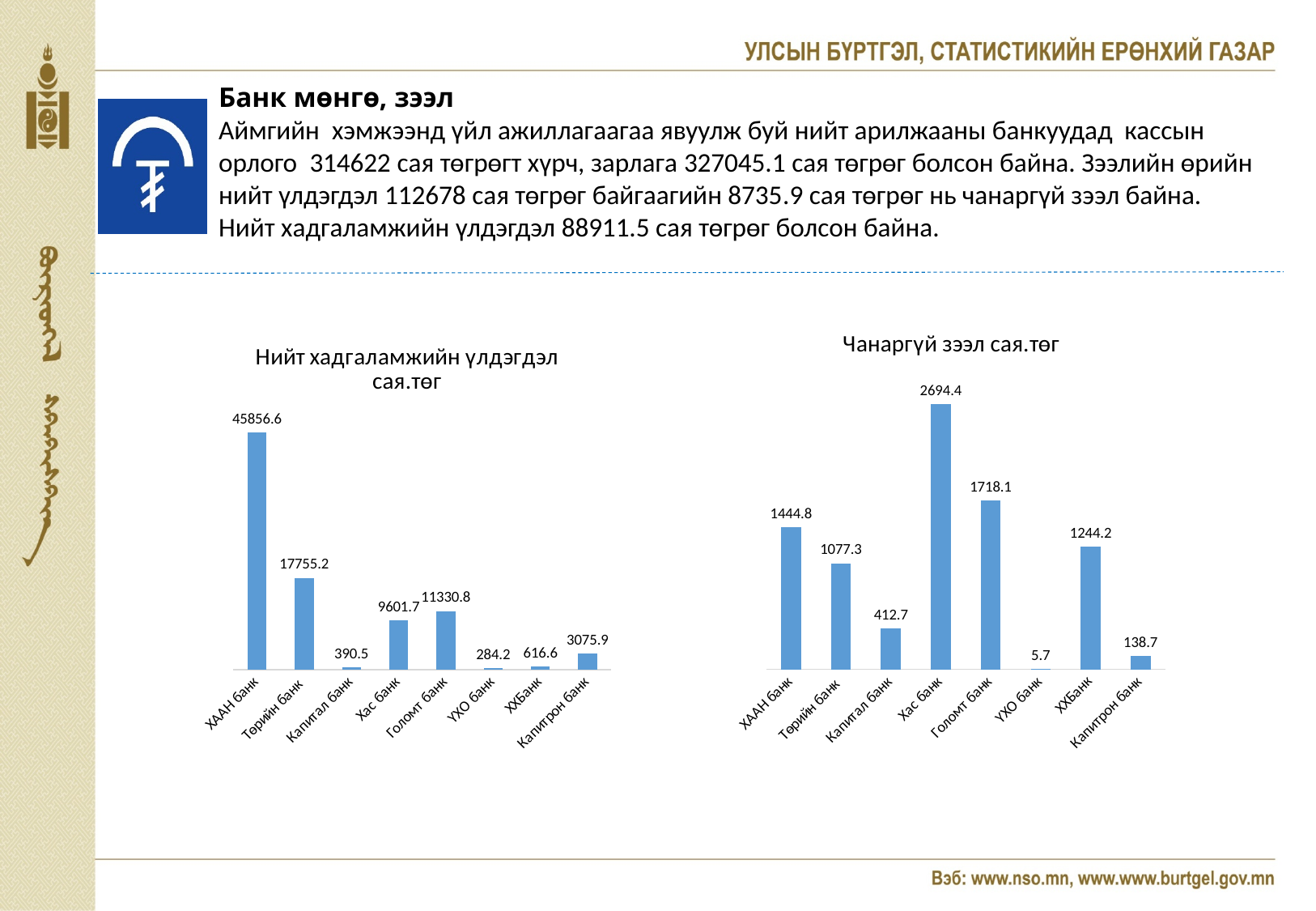
In the chart titled "Чанаргүй зээл сая.төг", what is the value for Хас банк? 2694.4 In the chart titled "Чанаргүй зээл сая.төг", what is the value for Капитрон банк? 138.7 What type of chart is the chart titled "Чанаргүй зээл сая.төг"? Bar chart In the chart titled "Чанаргүй зээл сая.төг", what is the difference between Хас банк and Голомт банк? 976.3 In the chart titled "Нийт хадгаламжийн үлдэгдэл сая.төг", what is the difference between ХААН банк and Төрийн банк? 28101.4 In the chart titled "Нийт хадгаламжийн үлдэгдэл сая.төг", what is the value for Голомт банк? 11330.8 In the chart titled "Чанаргүй зээл сая.төг", which bank has the lowest value? ҮХО банк In the chart titled "Чанаргүй зээл сая.төг", which is larger, ХААН банк or ХХБанк? ХААН банк In the chart titled "Нийт хадгаламжийн үлдэгдэл сая.төг", how many banks are shown? 8 In the chart titled "Нийт хадгаламжийн үлдэгдэл сая.төг", which bank has the lowest value? ҮХО банк In the chart titled "Чанаргүй зээл сая.төг", which bank has the highest value? Хас банк In the chart titled "Нийт хадгаламжийн үлдэгдэл сая.төг", what is the value for ХААН банк? 45856.6